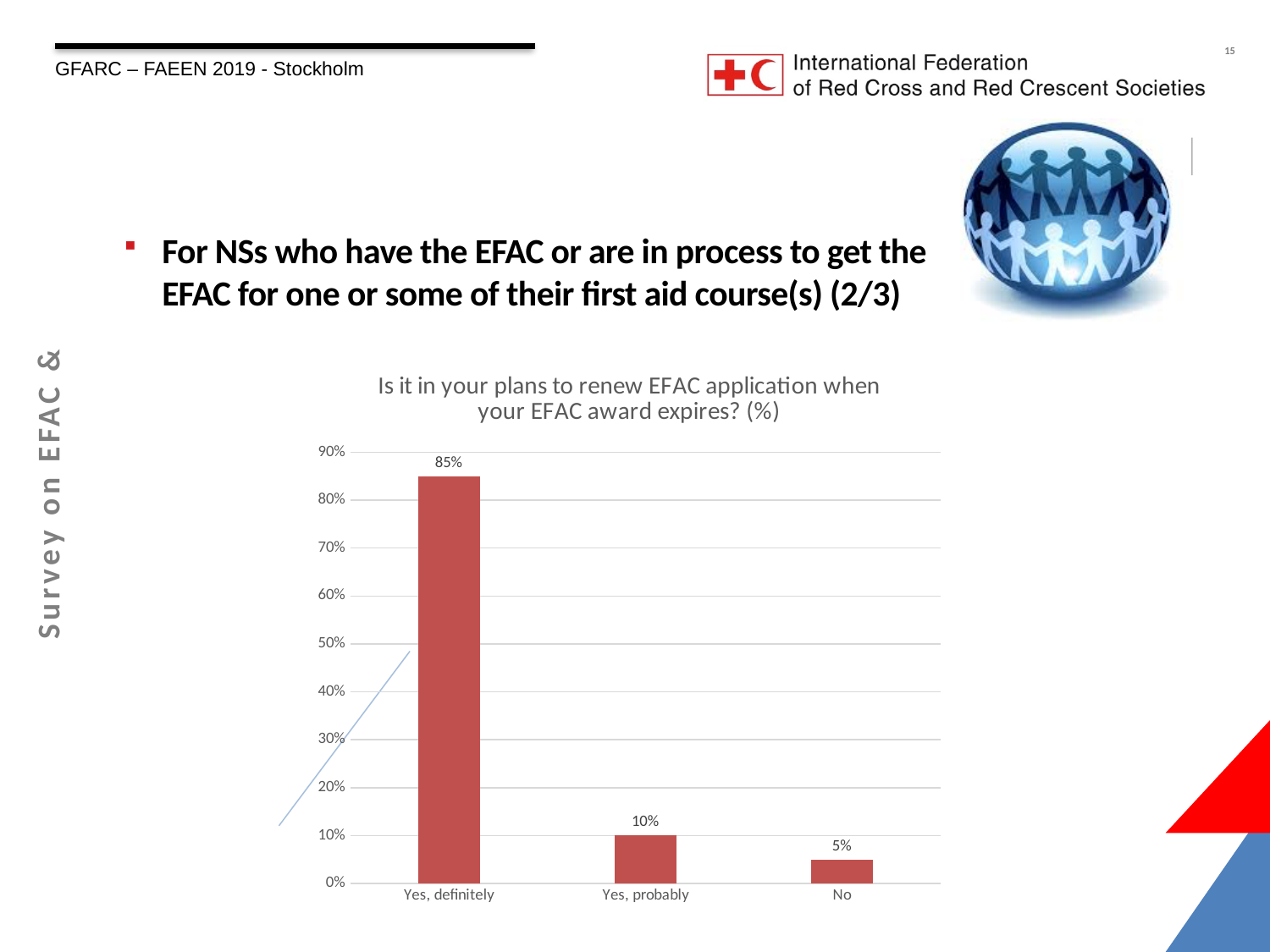
Which category has the highest value? Yes, definitely What is the difference between the values for "Yes, definitely" and "Yes, probably"? 75% Is the value for "Yes, definitely" greater or less than 80%? greater Which category has the lowest value? No What is the title of the chart? Is it in your plans to renew EFAC application when your EFAC award expires? (%) How many categories are shown on the x axis? 3 What is the value for "Yes, probably"? 10% What is the value for "No"? 5% What is the value for "Yes, definitely"? 85% Which is larger, the value for "Yes, probably" or the value for "No"? Yes, probably What is the difference between the values for "Yes, probably" and "No"? 5% What kind of chart is shown on the slide? bar chart